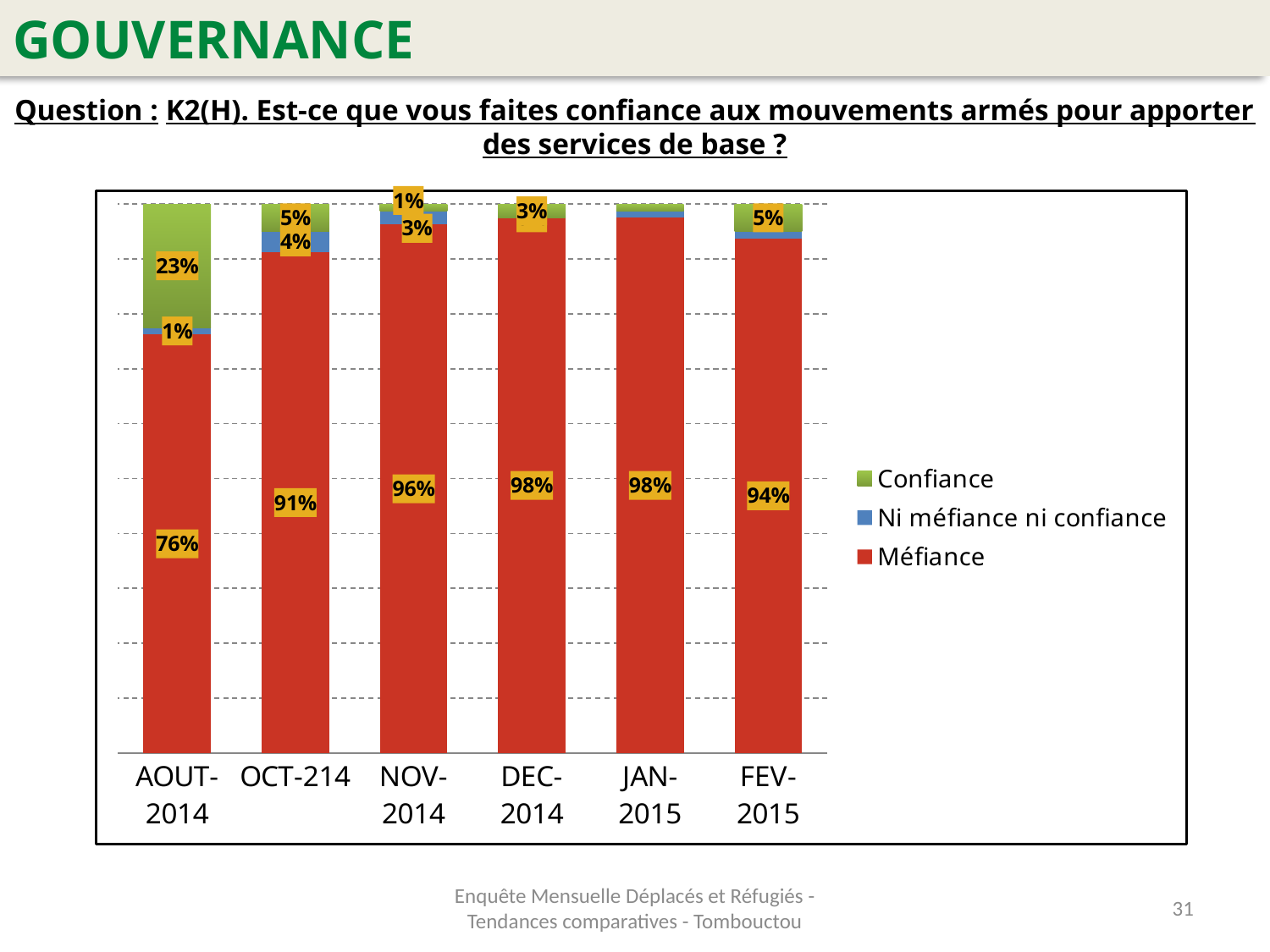
What is the Confiance value for AOUT-2014? 23% What is the difference between the Méfiance values for OCT-214 and AOUT-2014? 15 percentage points Does the Méfiance value rise or fall from AOUT-2014 to JAN-2015? Rises Which has the larger Méfiance value, NOV-2014 or FEV-2015? NOV-2014 What is the Méfiance value for FEV-2015? 94% What is the Méfiance value for AOUT-2014? 76% How many series does the legend list? 3 What is the Ni méfiance ni confiance value for OCT-214? 4% What kind of chart is shown on the slide? Stacked bar chart What is the Méfiance value for OCT-214? 91% How many months are shown on the x axis? 6 Which month has the lowest Méfiance value? AOUT-2014